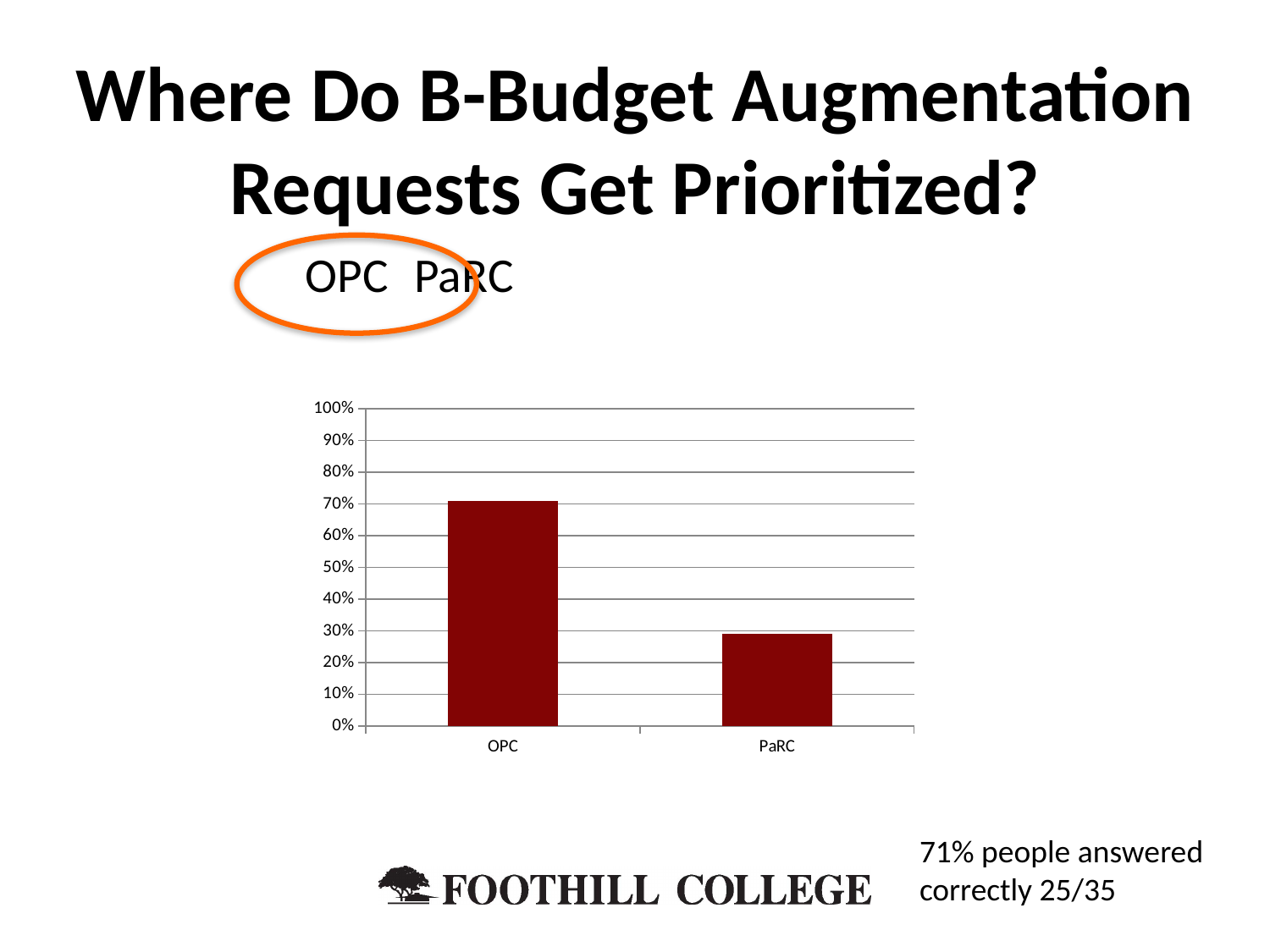
Is the value for PaRC greater or less than 20%? greater Which category has the lowest bar in the chart? PaRC How many categories are shown on the x axis of the chart? 2 Which bar is taller, OPC or PaRC? OPC What is the maximum value shown on the y axis of the chart? 100% What kind of chart is shown on the slide? bar chart Is the value for PaRC greater or less than 40%? less Is the value for OPC greater or less than 80%? less Which category has the highest bar in the chart? OPC What colour are the bars in the chart? dark red